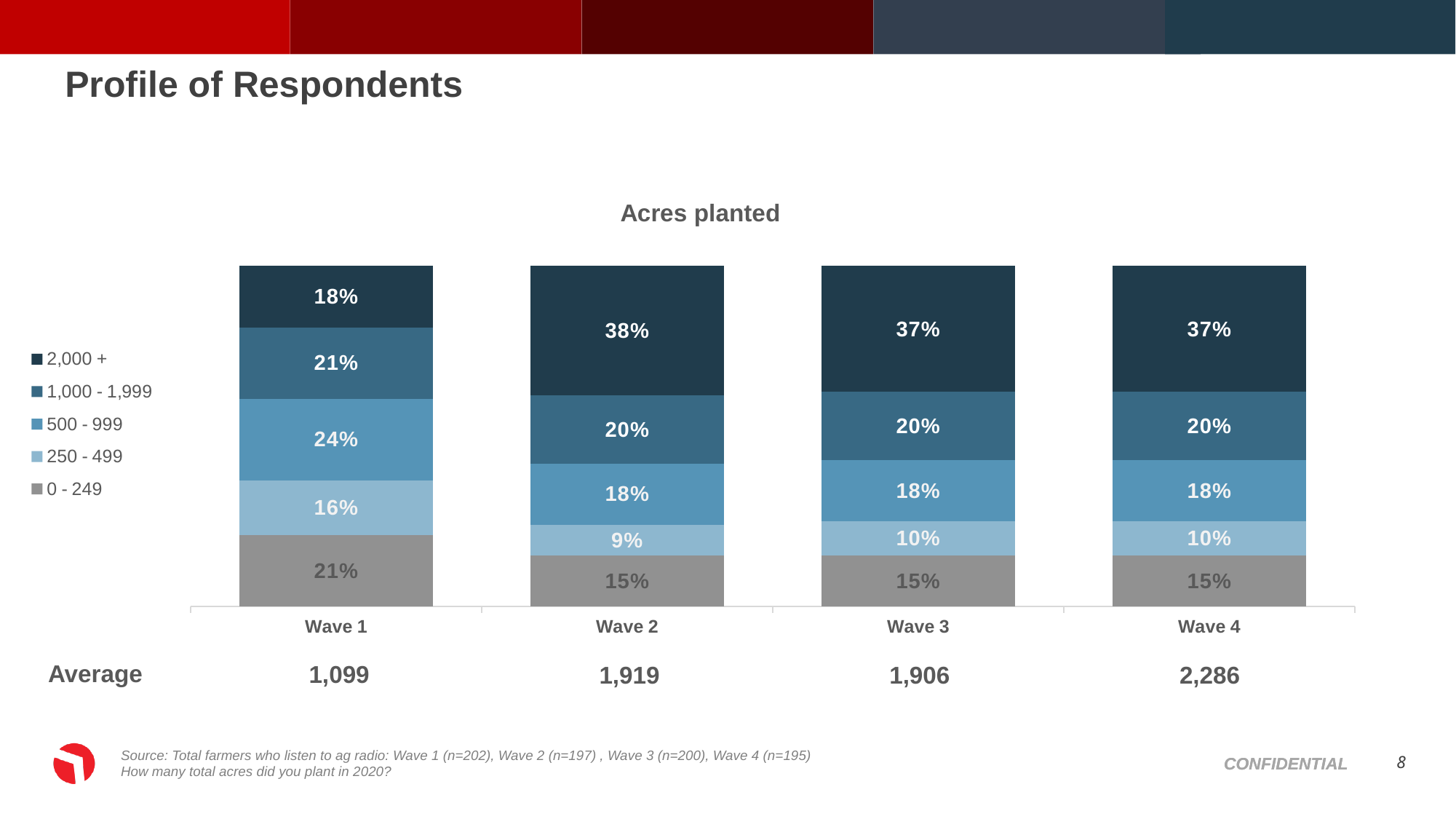
What type of chart is used to show Acres planted? Stacked bar chart In the Acres planted chart, which wave has the highest share of respondents in the 2,000 + category? Wave 2 How many acreage categories does the legend of the Acres planted chart list? 5 What is the title of the chart on the slide? Acres planted In the Acres planted chart, does the 2,000 + share rise or fall from Wave 1 to Wave 2? Rises In the Acres planted chart, what is the value for the 250 - 499 segment in Wave 3? 10% How many waves are shown on the x axis of the Acres planted chart? 4 In the Acres planted chart, by how many percentage points does the 2,000 + share in Wave 2 exceed the 2,000 + share in Wave 1? 20 percentage points In the Acres planted chart, which wave has the lowest share of respondents in the 250 - 499 category? Wave 2 In the Acres planted chart, which has the larger 0 - 249 share, Wave 1 or Wave 4? Wave 1 In the Acres planted chart, what is the value for the 500 - 999 segment in Wave 1? 24% In the Acres planted chart, what percentage of Wave 2 respondents planted 2,000 + acres? 38%